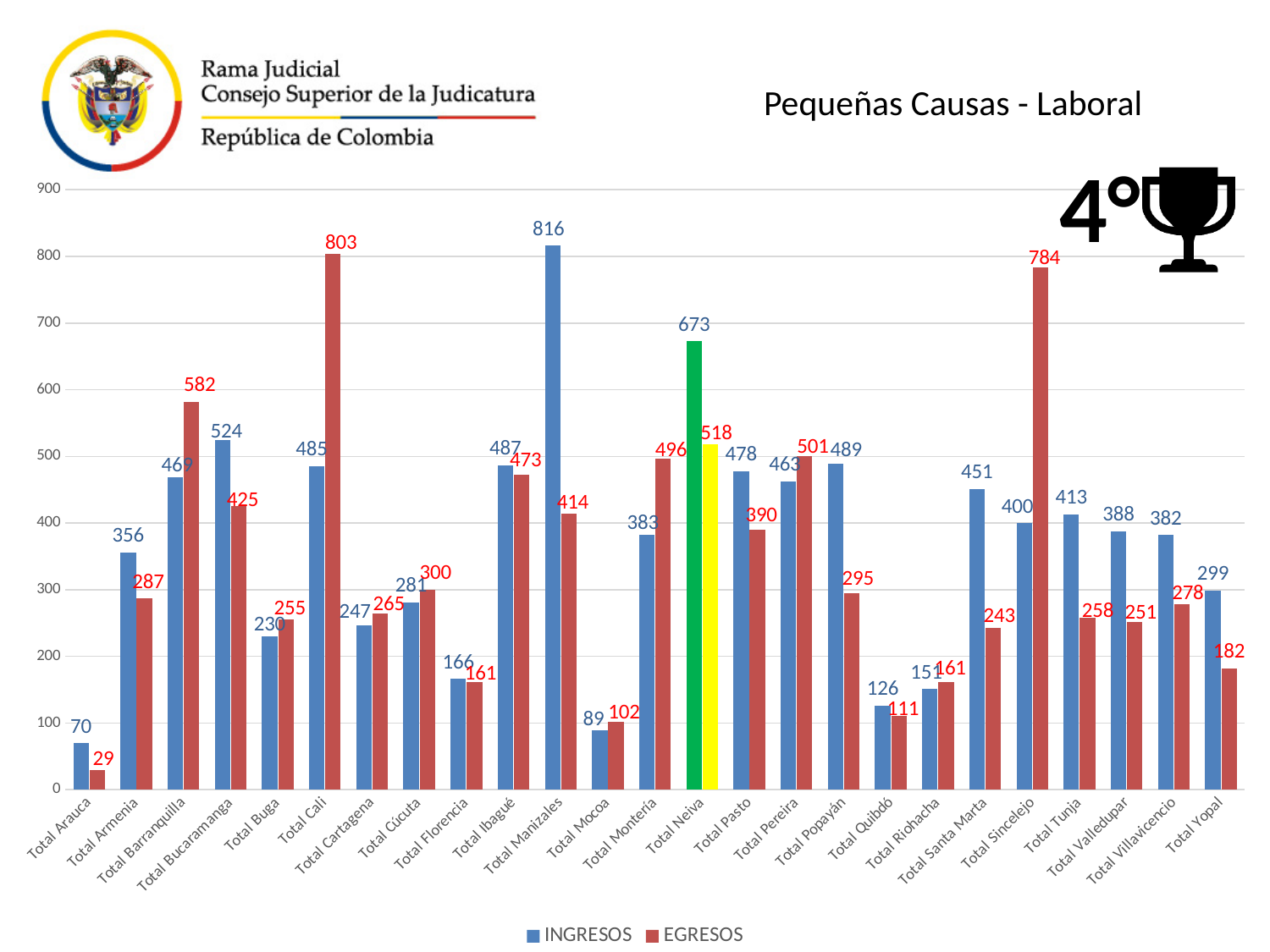
What is the EGRESOS value for Total Yopal? 182 How many categories are shown on the x axis? 25 What is the INGRESOS value for Total Manizales? 816 What is the EGRESOS value for Total Cali? 803 How many series does the legend list? 2 What is the difference between INGRESOS and EGRESOS for Total Sincelejo? 384 Which category has the highest INGRESOS value? Total Manizales Which category has the lowest EGRESOS value? Total Arauca What is the title of the chart? Pequeñas Causas - Laboral Which is larger for Total Barranquilla, INGRESOS or EGRESOS? EGRESOS What is the INGRESOS value for Total Neiva? 673 What kind of chart is shown on the slide? Bar chart